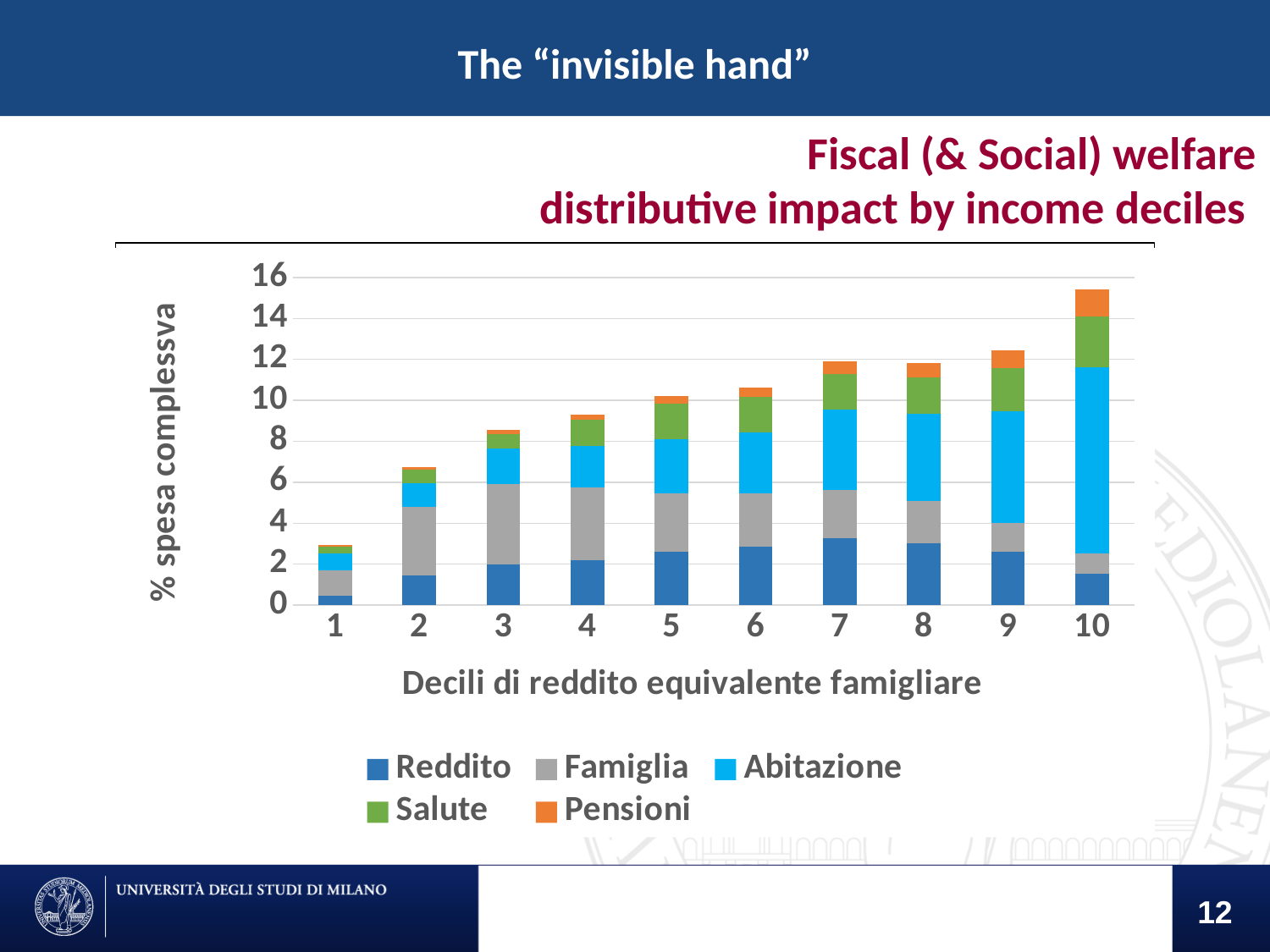
Is the total bar for decile 7 greater or less than 10? greater What kind of chart is shown on the slide? Stacked bar chart Which income decile has the lowest total bar in the chart? 1 Do the total bars generally rise or fall as the income decile increases from 1 to 10? Rise How many income deciles are shown on the x axis of the chart? 10 Which series forms the largest segment of the bar for decile 10? Abitazione Which has the larger total bar, decile 9 or decile 10? Decile 10 What is the title of the x axis of the chart? Decili di reddito equivalente famigliare Is the total bar for decile 10 greater or less than 14? greater Is the total bar for decile 1 greater or less than 4? less Which income decile has the highest total bar in the chart? 10 How many series does the chart's legend list? 5